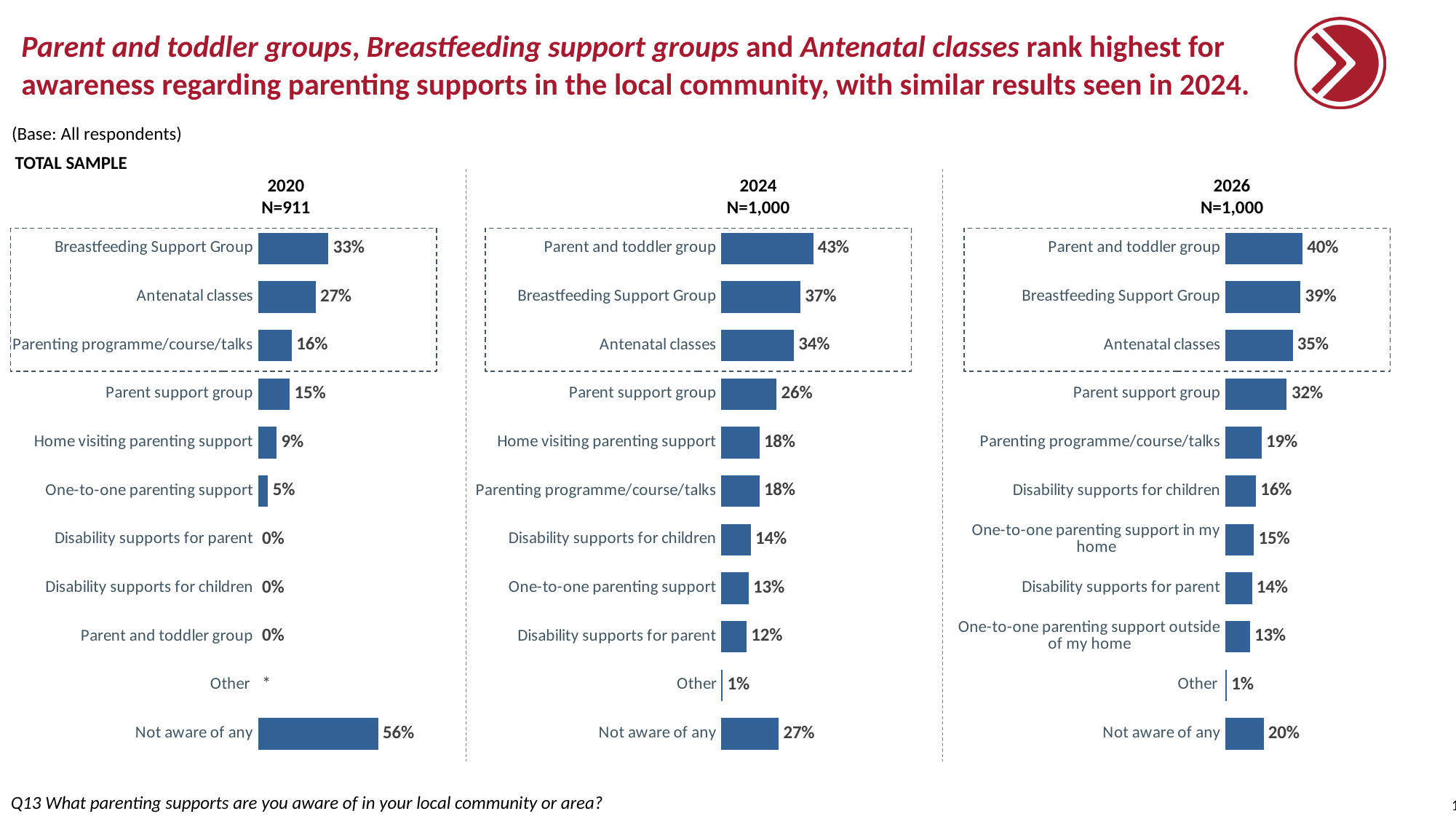
In the 2020 chart, which category has the highest value? Not aware of any Which is larger: Not aware of any in the 2020 chart or Not aware of any in the 2024 chart? 2020 In the 2024 chart, what is the value for Parent and toddler group? 43% How many categories are shown in the 2024 chart? 11 In the 2024 chart, which category has the lowest value? Other In the 2026 chart, what is the difference between Antenatal classes and Parent support group? 3% What kind of chart is used for the 2026 data? Bar chart In the 2026 chart, which category has the highest value? Parent and toddler group In the 2024 chart, what is the difference between Parent and toddler group and Breastfeeding Support Group? 6% In the 2020 chart, what percentage of respondents were aware of Breastfeeding Support Group? 33% What is the sample size (N) shown for the 2020 chart? N=911 In the 2026 chart, what is the value for Not aware of any? 20%